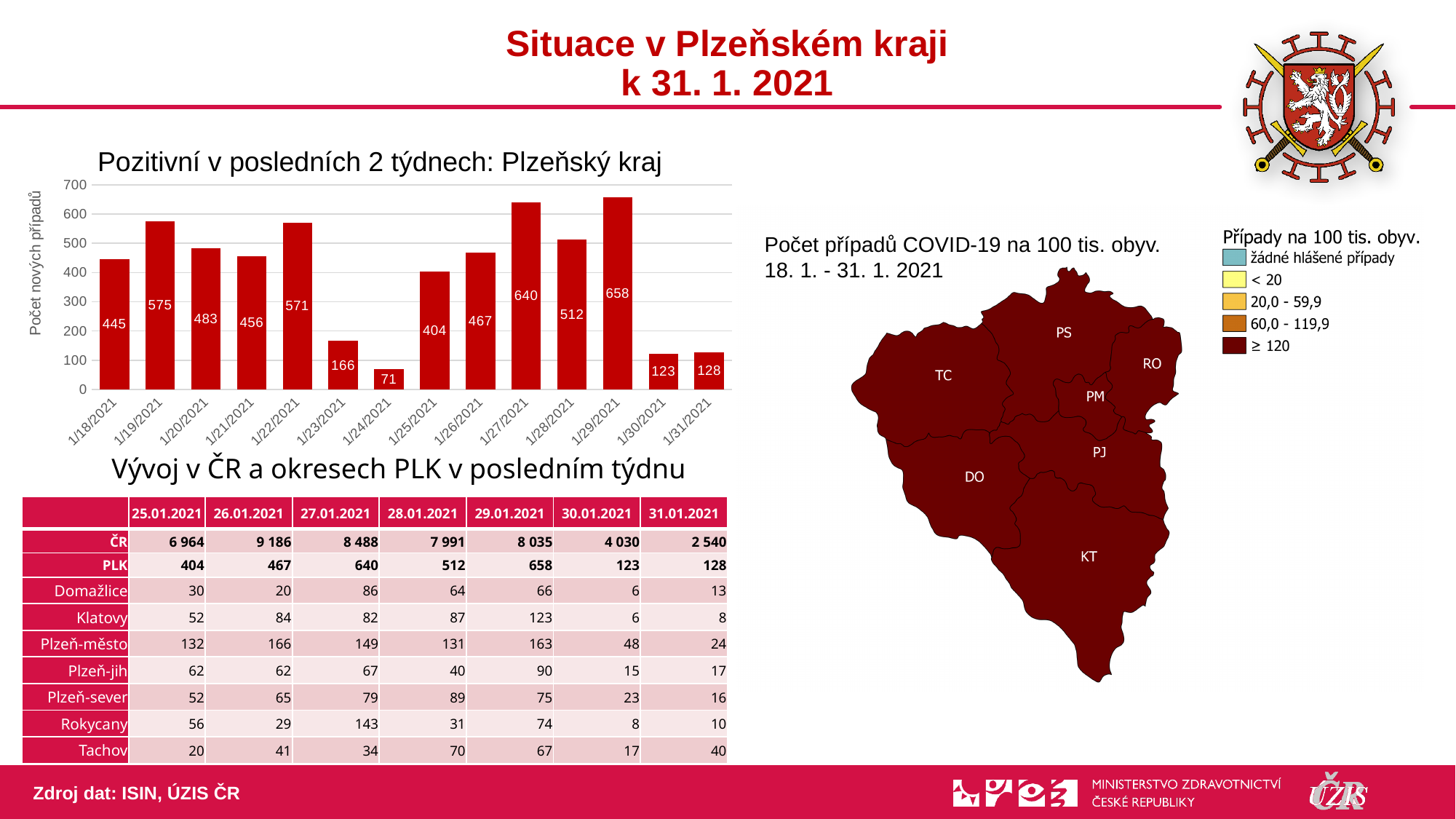
In the chart 'Pozitivní v posledních 2 týdnech: Plzeňský kraj', which date has the lowest value? 1/24/2021 What kind of chart is 'Pozitivní v posledních 2 týdnech: Plzeňský kraj'? bar chart In the chart 'Pozitivní v posledních 2 týdnech: Plzeňský kraj', is the value for 1/22/2021 greater or less than 500? greater In the chart 'Pozitivní v posledních 2 týdnech: Plzeňský kraj', what is the difference between the values for 1/29/2021 and 1/30/2021? 535 In the chart 'Pozitivní v posledních 2 týdnech: Plzeňský kraj', what is the difference between the values for 1/27/2021 and 1/28/2021? 128 In the chart 'Pozitivní v posledních 2 týdnech: Plzeňský kraj', which date has the highest value? 1/29/2021 In the chart 'Pozitivní v posledních 2 týdnech: Plzeňský kraj', what is the value for 1/24/2021? 71 In the chart 'Pozitivní v posledních 2 týdnech: Plzeňský kraj', what is the value for 1/31/2021? 128 In the chart 'Pozitivní v posledních 2 týdnech: Plzeňský kraj', what is the value for 1/19/2021? 575 What is the y-axis label of the chart 'Pozitivní v posledních 2 týdnech: Plzeňský kraj'? Počet nových případů In the chart 'Pozitivní v posledních 2 týdnech: Plzeňský kraj', which is larger, the value for 1/20/2021 or the value for 1/21/2021? 1/20/2021 How many dates are shown on the x axis of the chart 'Pozitivní v posledních 2 týdnech: Plzeňský kraj'? 14